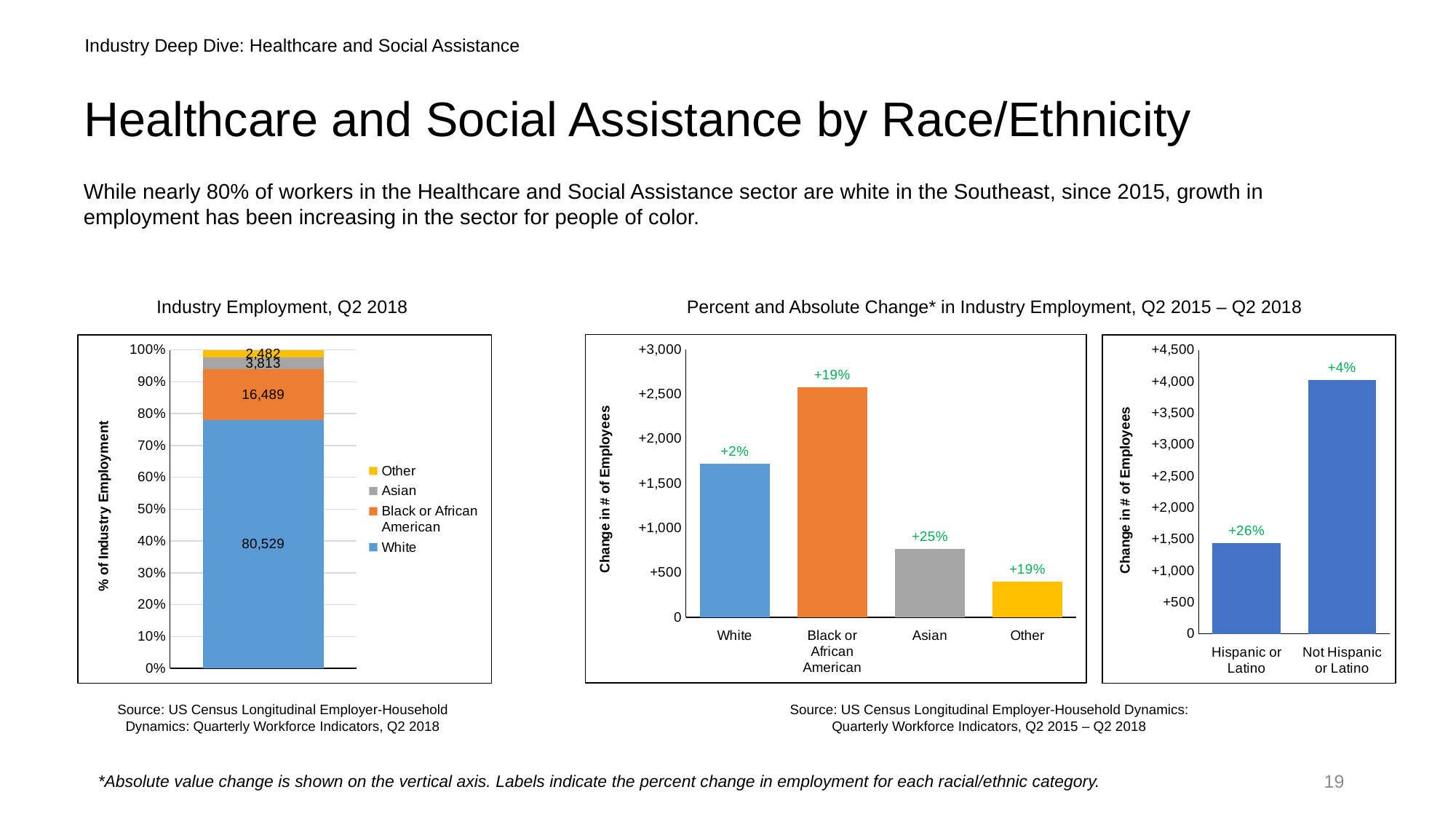
In the right chart (change in industry employment by Hispanic or Latino status), what percent change label is shown for Hispanic or Latino? +26% In the middle chart (Percent and Absolute Change in Industry Employment by race), which category has the largest absolute change in number of employees? Black or African American In the middle chart (Percent and Absolute Change in Industry Employment by race), which category has the smallest absolute change in number of employees? Other In the middle chart (Percent and Absolute Change in Industry Employment by race), what percent change label is shown for White? +2% In the right chart (change in industry employment by Hispanic or Latino status), is the absolute change for Not Hispanic or Latino greater or less than +3,500? greater In the Industry Employment, Q2 2018 chart, what is the value shown for Black or African American? 16,489 In the Industry Employment, Q2 2018 chart, what is the difference between the White and Black or African American values? 64,040 In the Industry Employment, Q2 2018 chart, what is the value shown for White? 80,529 In the middle chart (Percent and Absolute Change in Industry Employment by race), is the absolute change for Asian greater or less than +1,000? less In the middle chart (Percent and Absolute Change in Industry Employment by race), what percent change label is shown for Asian? +25% How many series does the legend of the Industry Employment, Q2 2018 chart list? 4 In the Industry Employment, Q2 2018 chart, what is the value shown for Asian? 3,813